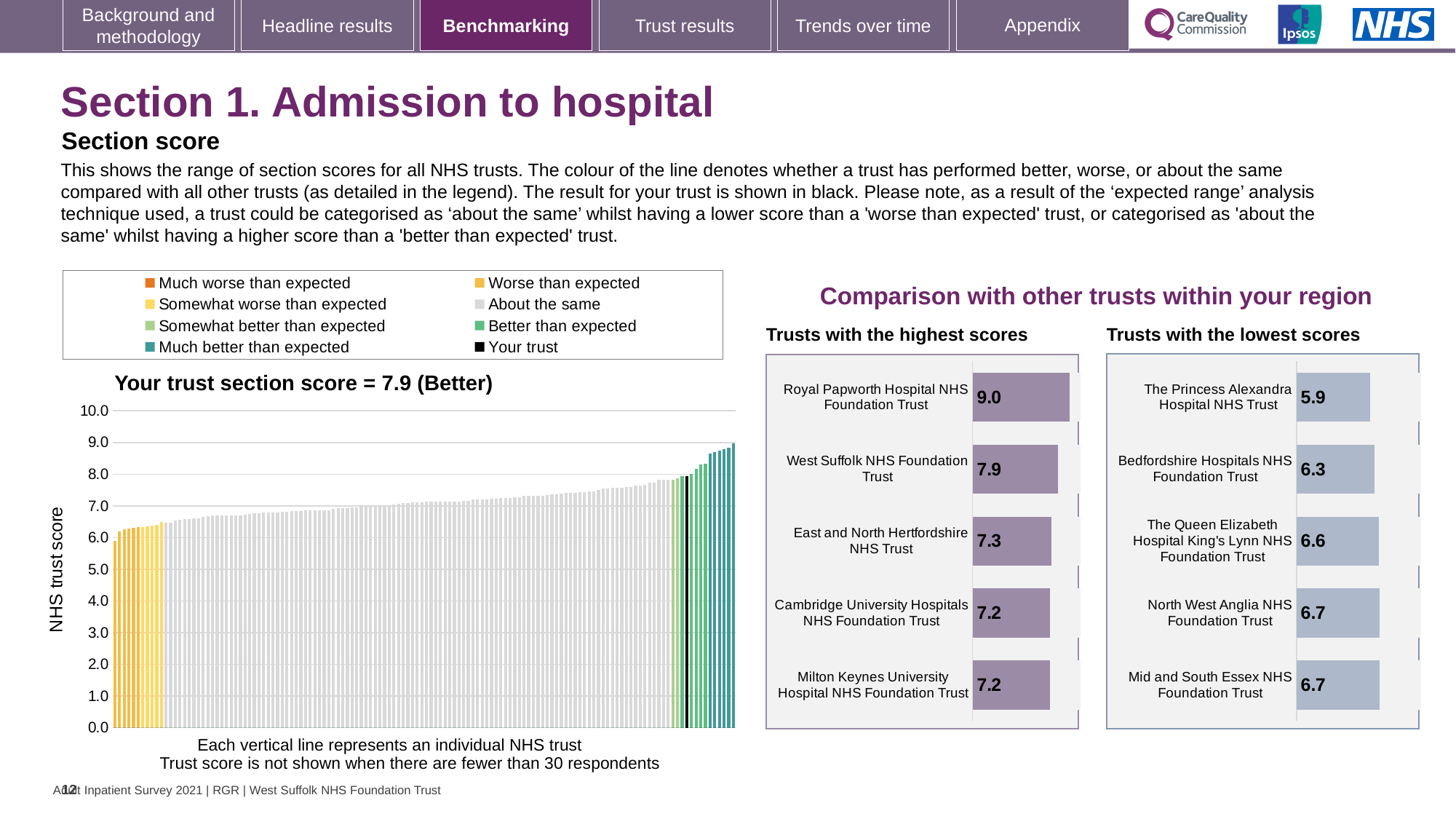
In the 'Trusts with the highest scores' chart, what is the difference between the scores of Royal Papworth Hospital NHS Foundation Trust and West Suffolk NHS Foundation Trust? 1.1 In the 'Your trust section score' chart, what is the section score for your trust? 7.9 In the 'Your trust section score' chart, do the trust scores rise or fall from left to right? Rise In the 'Trusts with the lowest scores' chart, which trust has the lowest score? The Princess Alexandra Hospital NHS Trust What is the y-axis label of the 'Your trust section score = 7.9 (Better)' chart? NHS trust score How many trusts are shown in the 'Trusts with the highest scores' chart? 5 In the 'Trusts with the highest scores' chart, which trust has the highest score? Royal Papworth Hospital NHS Foundation Trust In the 'Trusts with the lowest scores' chart, what is the score for Bedfordshire Hospitals NHS Foundation Trust? 6.3 In the 'Trusts with the lowest scores' chart, which has the larger score: The Princess Alexandra Hospital NHS Trust or The Queen Elizabeth Hospital King's Lynn NHS Foundation Trust? The Queen Elizabeth Hospital King's Lynn NHS Foundation Trust How many entries does the legend above the 'Your trust section score' chart list? 8 In the 'Trusts with the highest scores' chart, what is the score for Royal Papworth Hospital NHS Foundation Trust? 9.0 What kind of chart is the 'Your trust section score = 7.9 (Better)' chart? Bar chart